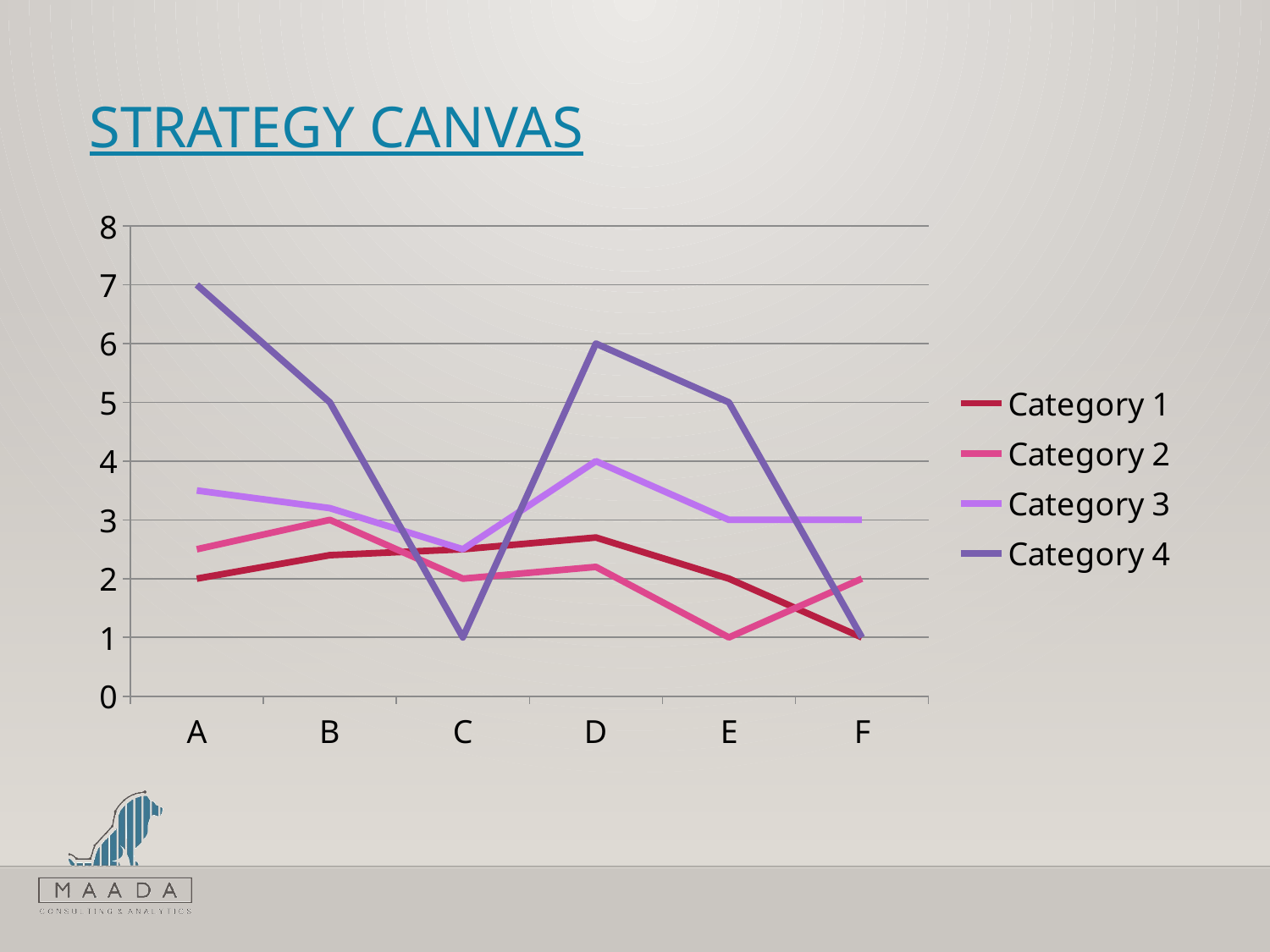
What is the difference between the Category 4 value at A and at D? 1 What kind of chart is shown on the slide? line chart What is the value of Category 4 at D? 6 How many categories are shown on the x axis? 6 At which x-axis category does Category 4 reach its highest value? A What is the value of Category 4 at A? 7 What is the value of Category 3 at D? 4 Is the value for Category 3 at A greater or less than 3? greater How many series does the legend list? 4 What is the value of Category 2 at E? 1 At A, which is larger: Category 4 or Category 1? Category 4 Does Category 1 rise or fall from D to F? fall